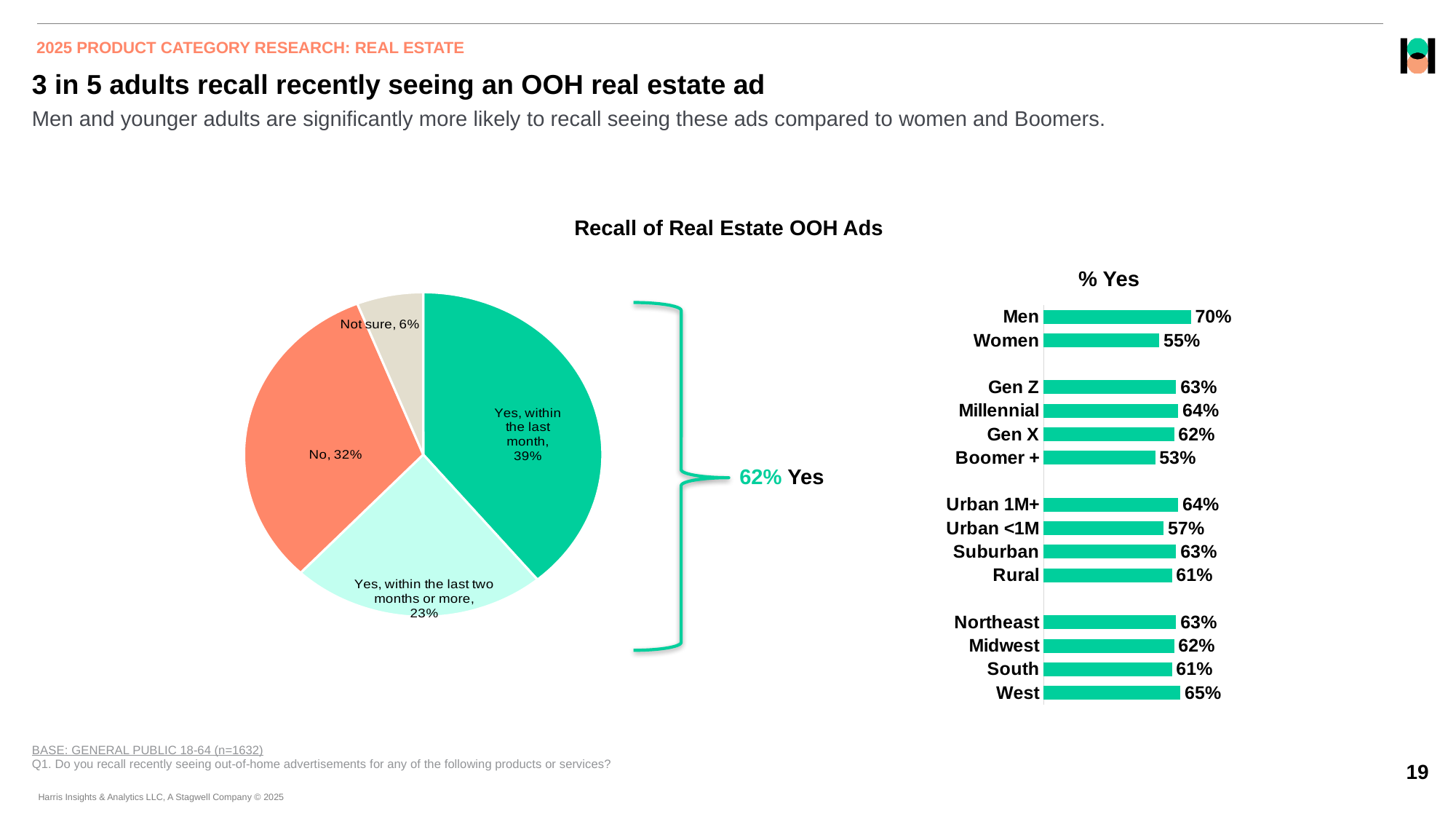
What kind of chart is the '% Yes' chart on the right? Bar chart In the pie chart, what share of respondents answered 'No'? 32% In the '% Yes' bar chart, which group has the lowest value? Boomer + In the '% Yes' bar chart, which is larger, Urban 1M+ or Urban <1M? Urban 1M+ In the pie chart, how many slices are there? 4 In the pie chart, what share answered 'Yes, within the last month'? 39% In the '% Yes' bar chart, which group has the highest value? Men In the pie chart, which slice is the smallest? Not sure In the '% Yes' bar chart, what is the value for West? 65% In the pie chart, what is the combined share of the two 'Yes' slices? 62% In the '% Yes' bar chart, what is the difference between Men and Women? 15% In the '% Yes' bar chart, what is the value for Women? 55%